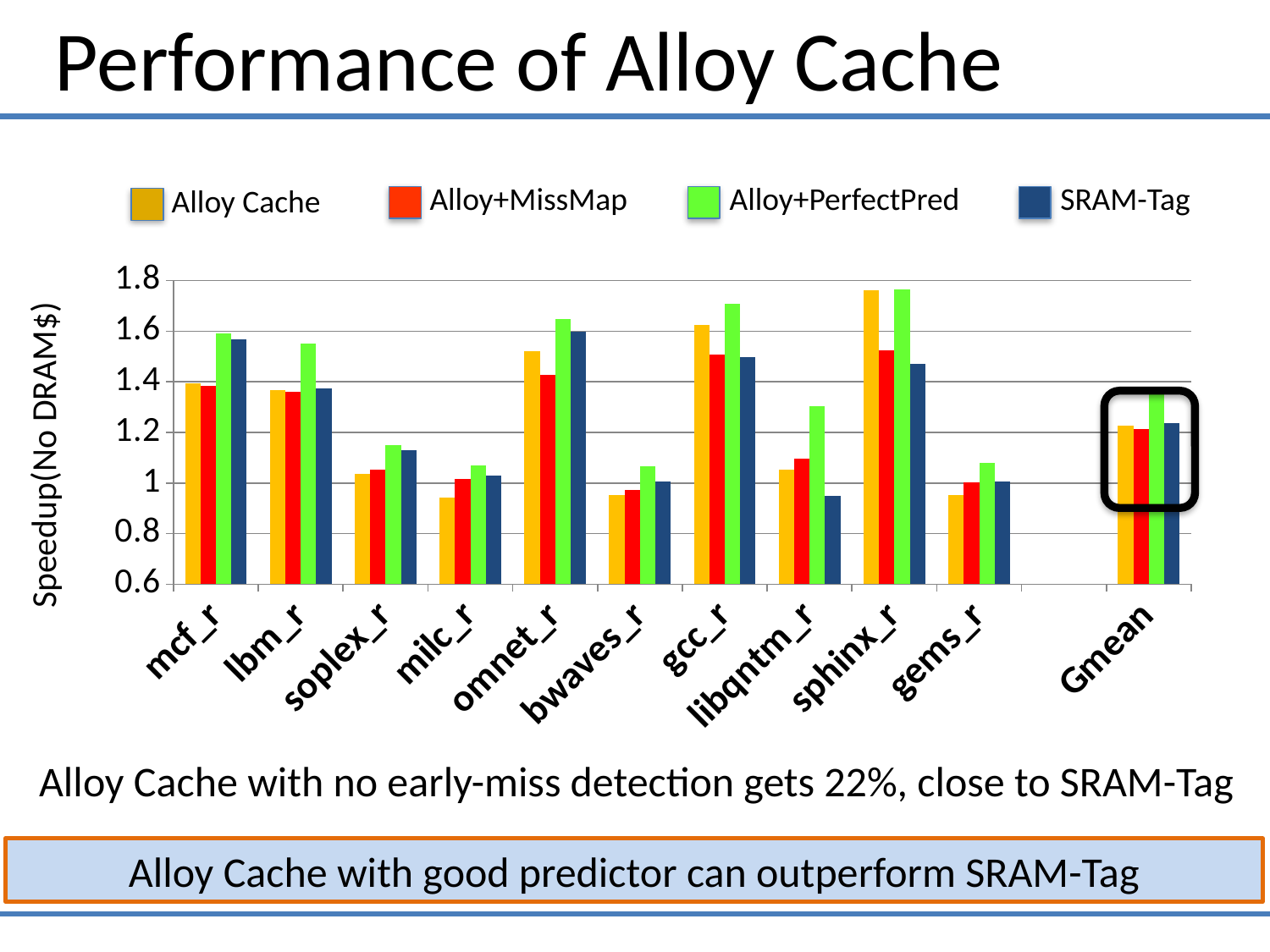
How many categories are shown along the x axis? 11 Is the SRAM-Tag value for libqntm_r greater or less than 1? less For gcc_r, which is larger: the Alloy Cache value or the SRAM-Tag value? Alloy Cache What kind of chart is shown on the slide? bar chart How many series does the legend list? 4 Is the Alloy Cache value for milc_r greater or less than 1? less Is the Alloy Cache value for sphinx_r greater or less than 1.6? greater What is the label on the y axis? Speedup(No DRAM$) For libqntm_r, which is larger: the Alloy+PerfectPred value or the SRAM-Tag value? Alloy+PerfectPred Which category has the lowest SRAM-Tag value? libqntm_r Which category has the highest Alloy Cache value? sphinx_r